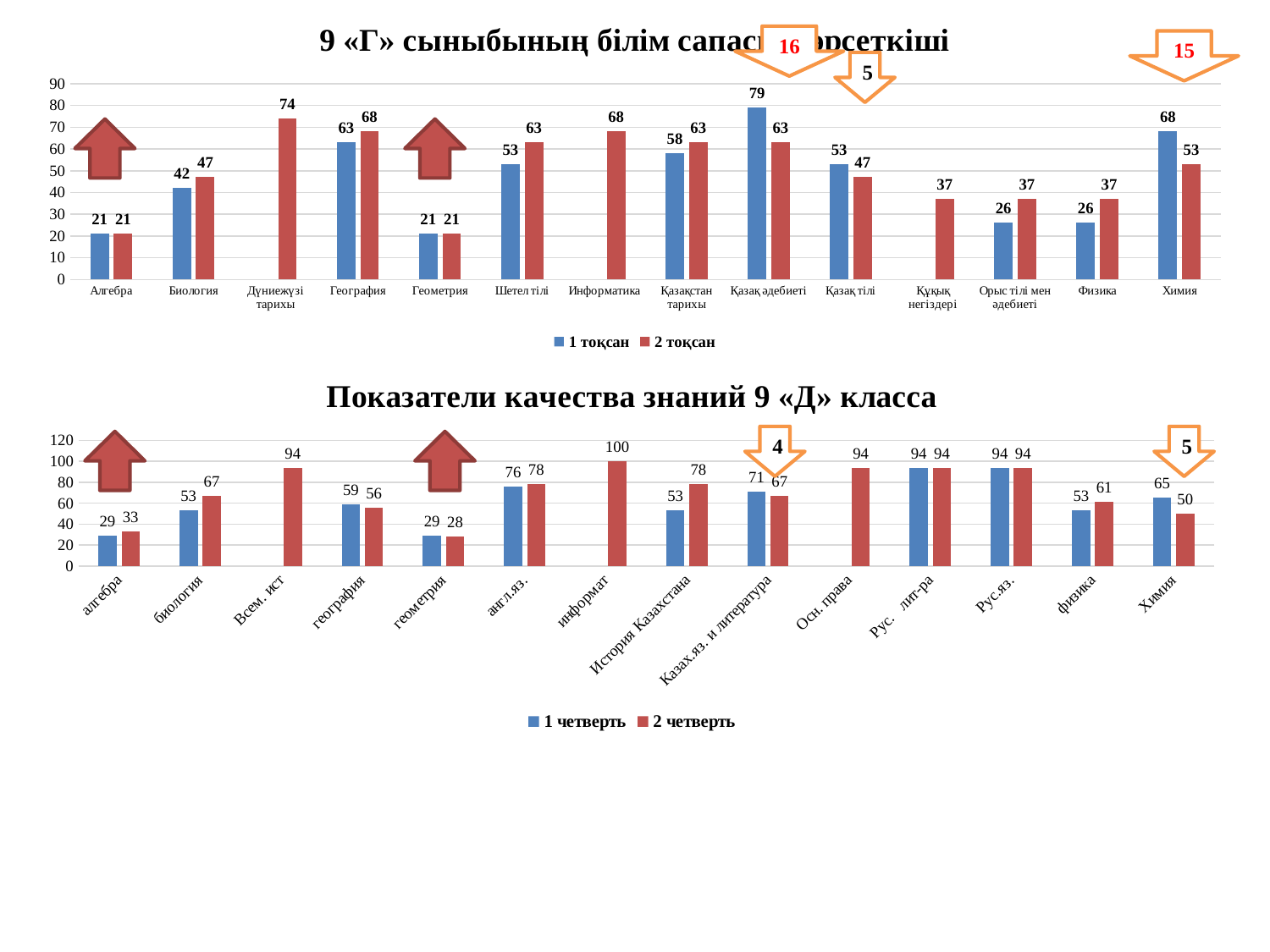
In the chart titled 'Показатели качества знаний 9 «Д» класса', what is the 2 четверть value for информат? 100 In the top chart, what is the value for Биология in the 2 тоқсан series? 47 In the top chart, what is the 1 тоқсан value for Қазақ әдебиеті? 79 In the top chart, which category has the highest 1 тоқсан value? Қазақ әдебиеті In the chart titled 'Показатели качества знаний 9 «Д» класса', which category has the lowest 2 четверть value? геометрия In the top chart, what is the difference between the 1 тоқсан and 2 тоқсан values for Химия? 15 In the chart titled 'Показатели качества знаний 9 «Д» класса', which is larger for Химия: the 1 четверть value or the 2 четверть value? 1 четверть In the chart titled 'Показатели качества знаний 9 «Д» класса', what is the difference between the 1 четверть and 2 четверть values for История Казахстана? 25 In the top chart, how many series does the legend list? 2 What type of chart is 'Показатели качества знаний 9 «Д» класса'? Bar chart In the chart titled 'Показатели качества знаний 9 «Д» класса', what are the two legend entries? 1 четверть and 2 четверть In the top chart, how many categories are shown on the x axis? 14